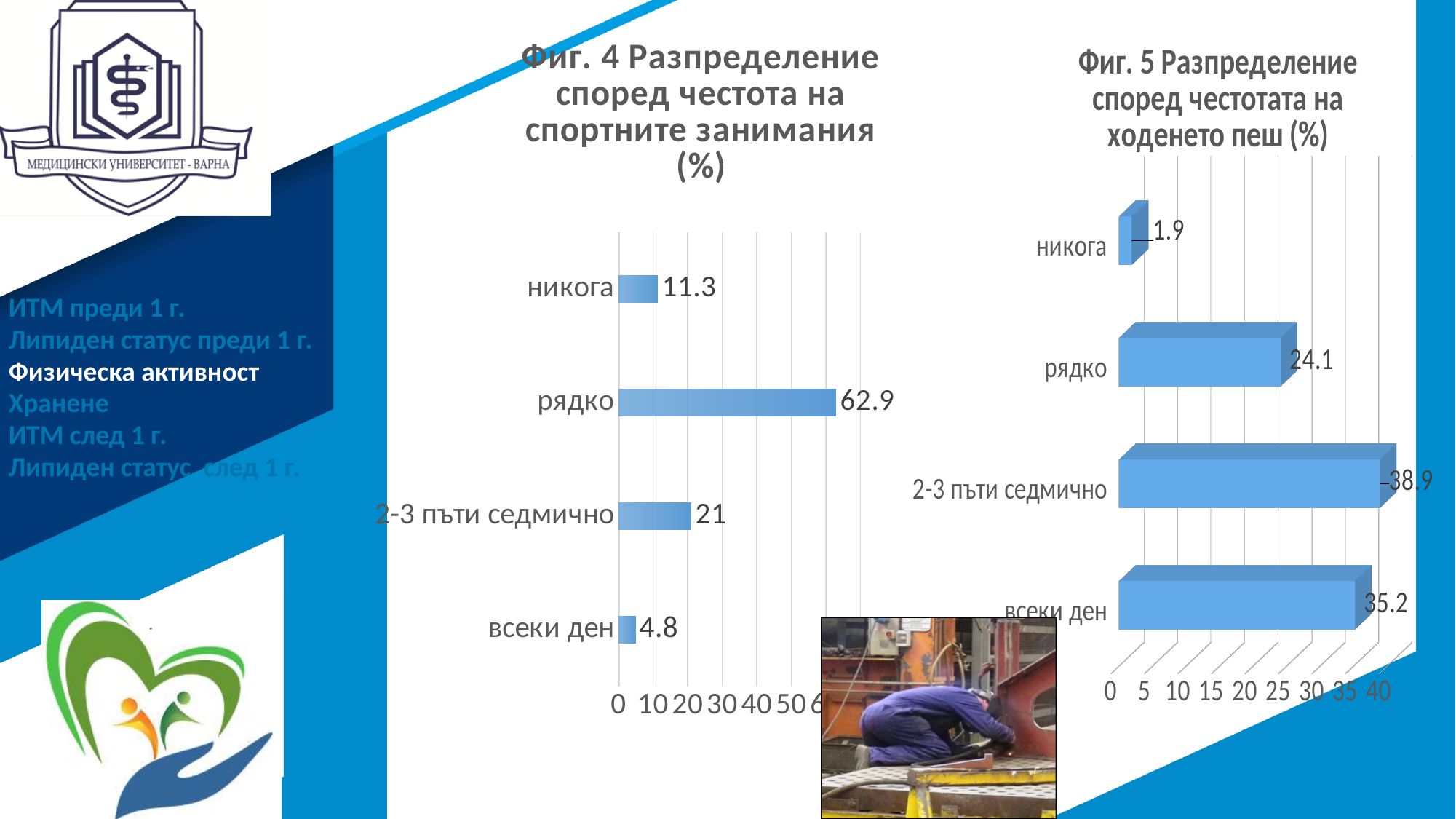
In the chart titled "Фиг. 4 Разпределение според честота на спортните занимания (%)", which category has the highest value? рядко In the chart titled "Фиг. 4 Разпределение според честота на спортните занимания (%)", what is the value for "рядко"? 62.9 In the chart titled "Фиг. 5 Разпределение според честотата на ходенето пеш (%)", which category has the lowest value? никога What kind of chart is the one titled "Фиг. 5 Разпределение според честотата на ходенето пеш (%)"? bar chart In the chart titled "Фиг. 5 Разпределение според честотата на ходенето пеш (%)", which is larger, the value for "рядко" or the value for "всеки ден"? всеки ден In the chart titled "Фиг. 4 Разпределение според честота на спортните занимания (%)", which category has the lowest value? всеки ден In the chart titled "Фиг. 5 Разпределение според честотата на ходенето пеш (%)", what is the value for "2-3 пъти седмично"? 38.9 In the chart titled "Фиг. 4 Разпределение според честота на спортните занимания (%)", what is the difference between the values for "2-3 пъти седмично" and "никога"? 9.7 In the chart titled "Фиг. 4 Разпределение според честота на спортните занимания (%)", what is the value for "всеки ден"? 4.8 In the chart titled "Фиг. 5 Разпределение според честотата на ходенето пеш (%)", what is the difference between the values for "2-3 пъти седмично" and "всеки ден"? 3.7 In the chart titled "Фиг. 4 Разпределение според честота на спортните занимания (%)", how many categories are shown? 4 In the chart titled "Фиг. 5 Разпределение според честотата на ходенето пеш (%)", what is the value for "никога"? 1.9